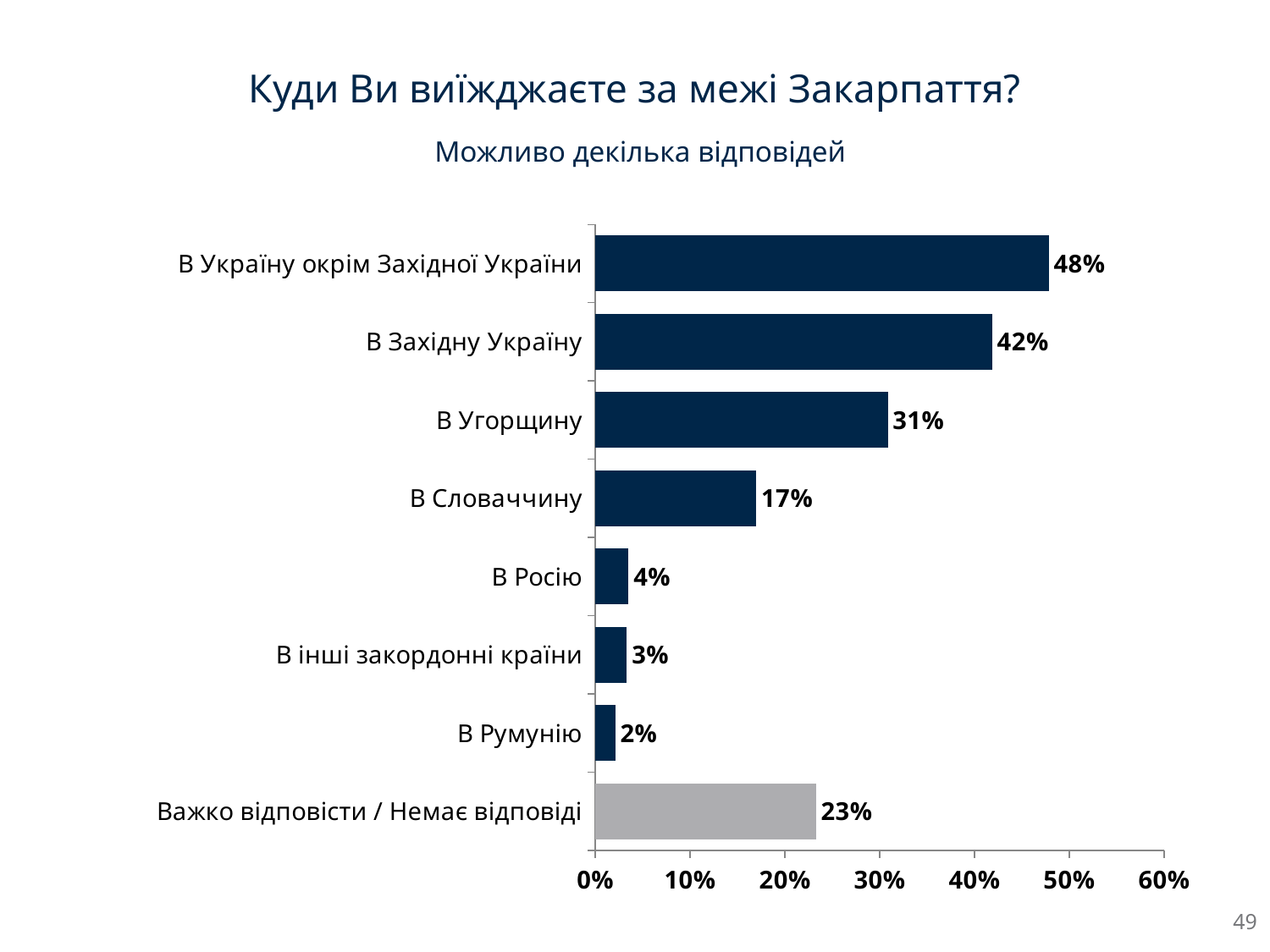
What is the difference between the values for "В Україну окрім Західної України" and "В Західну Україну"? 6% Is the value for "В Західну Україну" greater or less than 40%? greater Which category has the highest value? В Україну окрім Західної України What kind of chart is shown on the slide? bar chart Which is larger, the value for "В Угорщину" or the value for "Важко відповісти / Немає відповіді"? В Угорщину What is the title of the chart on the slide? Куди Ви виїжджаєте за межі Закарпаття? Which category has the lowest value? В Румунію Which bar is coloured grey rather than dark blue? Важко відповісти / Немає відповіді What is the value for "В Угорщину"? 31% How many categories are shown in the chart? 8 What is the value for "В Словаччину"? 17% What is the value for "Важко відповісти / Немає відповіді"? 23%